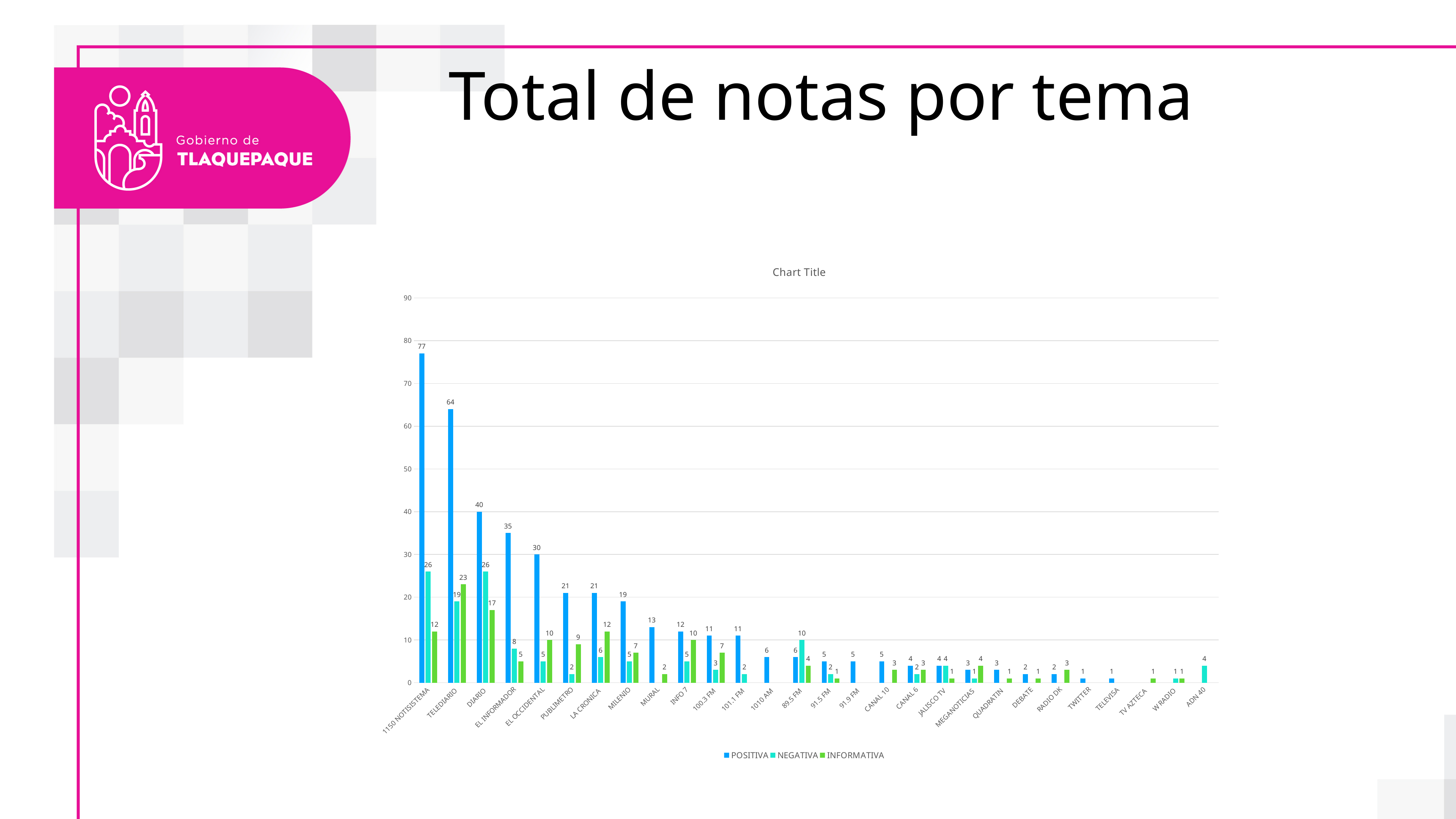
Is the POSITIVA value for EL INFORMADOR greater or less than 30? greater What is the difference between the POSITIVA values for 1150 NOTISISTEMA and TELEDIARIO? 13 What kind of chart is shown on the slide? Bar chart Which category has the highest POSITIVA value? 1150 NOTISISTEMA What are the three series named in the legend? POSITIVA, NEGATIVA, INFORMATIVA What is the NEGATIVA value for TELEDIARIO? 19 How many categories are shown on the x axis? 28 Which is larger for 89.5 FM: the POSITIVA value or the NEGATIVA value? NEGATIVA What is the INFORMATIVA value for DIARIO? 17 What is the POSITIVA value for 1150 NOTISISTEMA? 77 Which category has the highest INFORMATIVA value? TELEDIARIO How many series does the legend list? 3